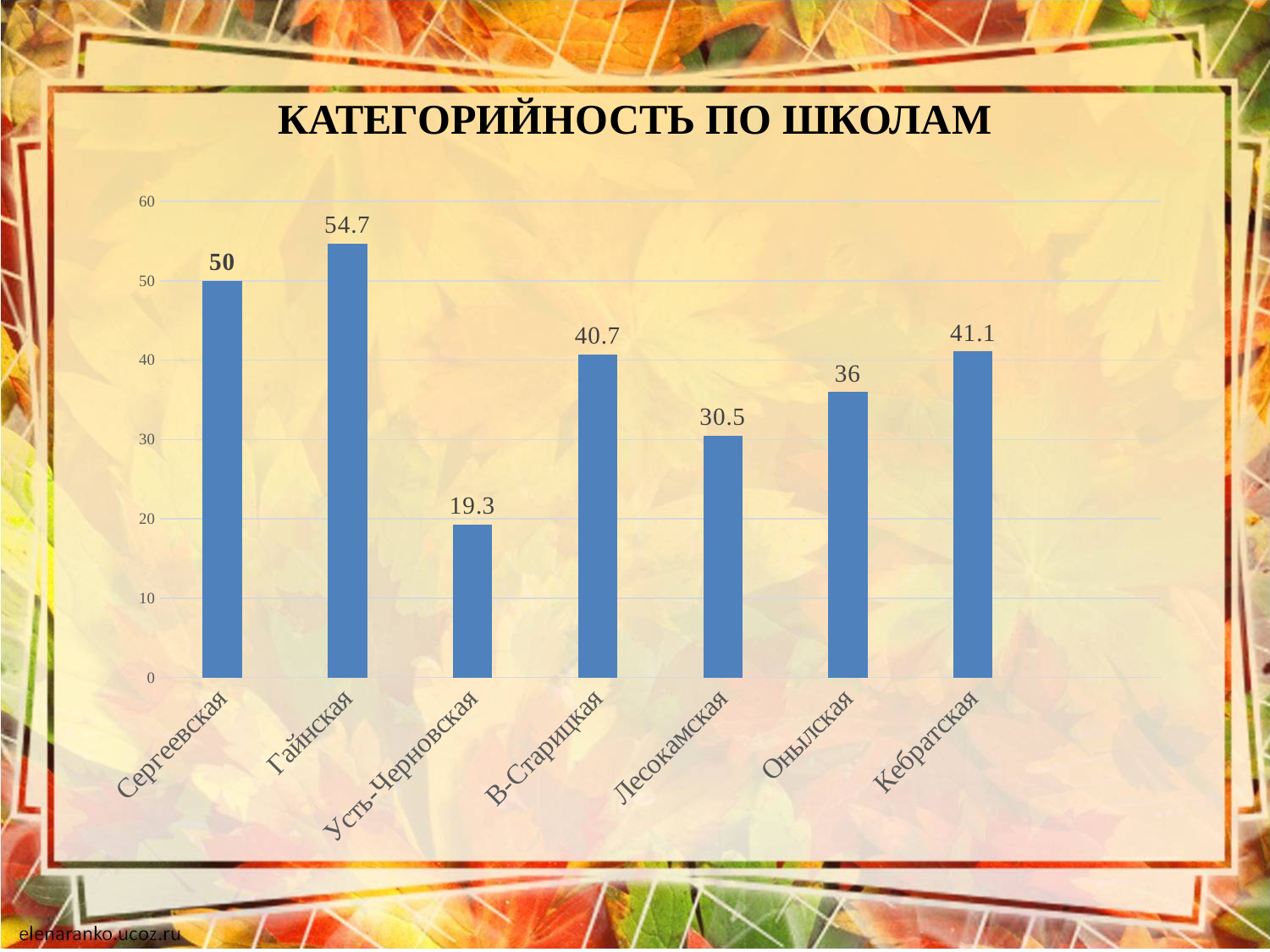
What is the difference between the values for Кебратская and Онылская? 5.1 What is the value for Кебратская? 41.1 What kind of chart is shown on the slide? Bar chart Which is larger, the value for В-Старицкая or the value for Лесокамская? В-Старицкая What is the value for Лесокамская? 30.5 What is the title of the chart? КАТЕГОРИЙНОСТЬ ПО ШКОЛАМ What is the difference between the values for Гайнская and Сергеевская? 4.7 How many schools are shown on the chart? 7 Which school has the highest value? Гайнская What is the value for Гайнская? 54.7 What is the value for Усть-Черновская? 19.3 Which school has the lowest value? Усть-Черновская